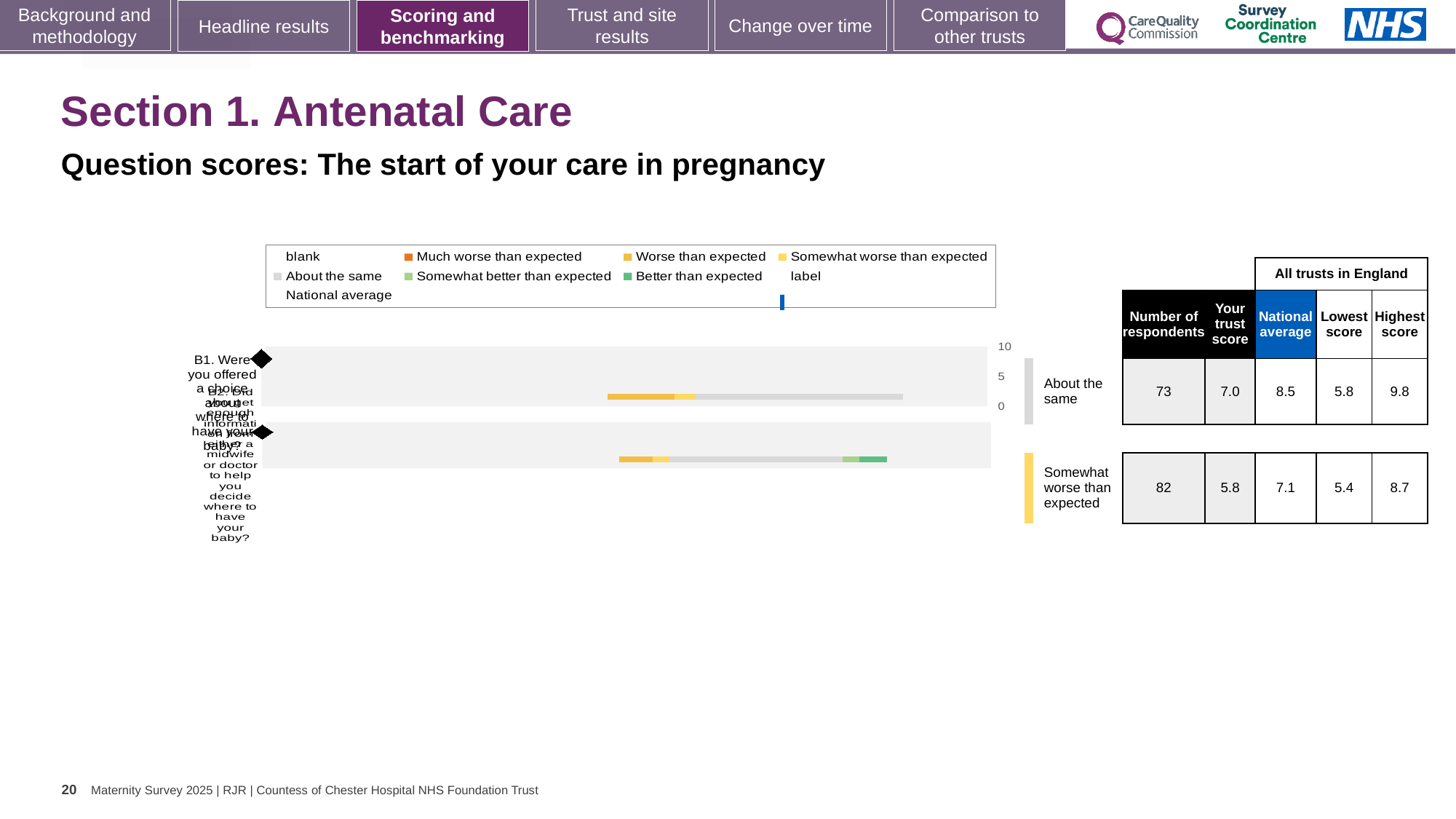
Which legend entry is shown in dark green? Better than expected In the table beside the chart, what is the lowest score across all trusts in England for the row rated 'Somewhat worse than expected'? 5.4 What kind of chart is shown on the slide? bar chart In the table beside the chart, what is the difference between the national average and the trust score for the row rated 'About the same'? 1.5 In the table beside the chart, how many respondents are listed for the row rated 'Somewhat worse than expected'? 82 How many questions (categories) are plotted in the chart? 2 In the table beside the chart, which row has the higher trust score: 'About the same' or 'Somewhat worse than expected'? About the same What is the highest tick value shown on the chart's score axis? 10 In the table beside the chart, what is the trust score for the row rated 'Somewhat worse than expected'? 5.8 In the table beside the chart, what is the highest score across all trusts in England for the row rated 'About the same'? 9.8 In the table beside the chart, what is the trust score for the row rated 'About the same'? 7.0 In the table beside the chart, what is the national average for the row rated 'About the same'? 8.5